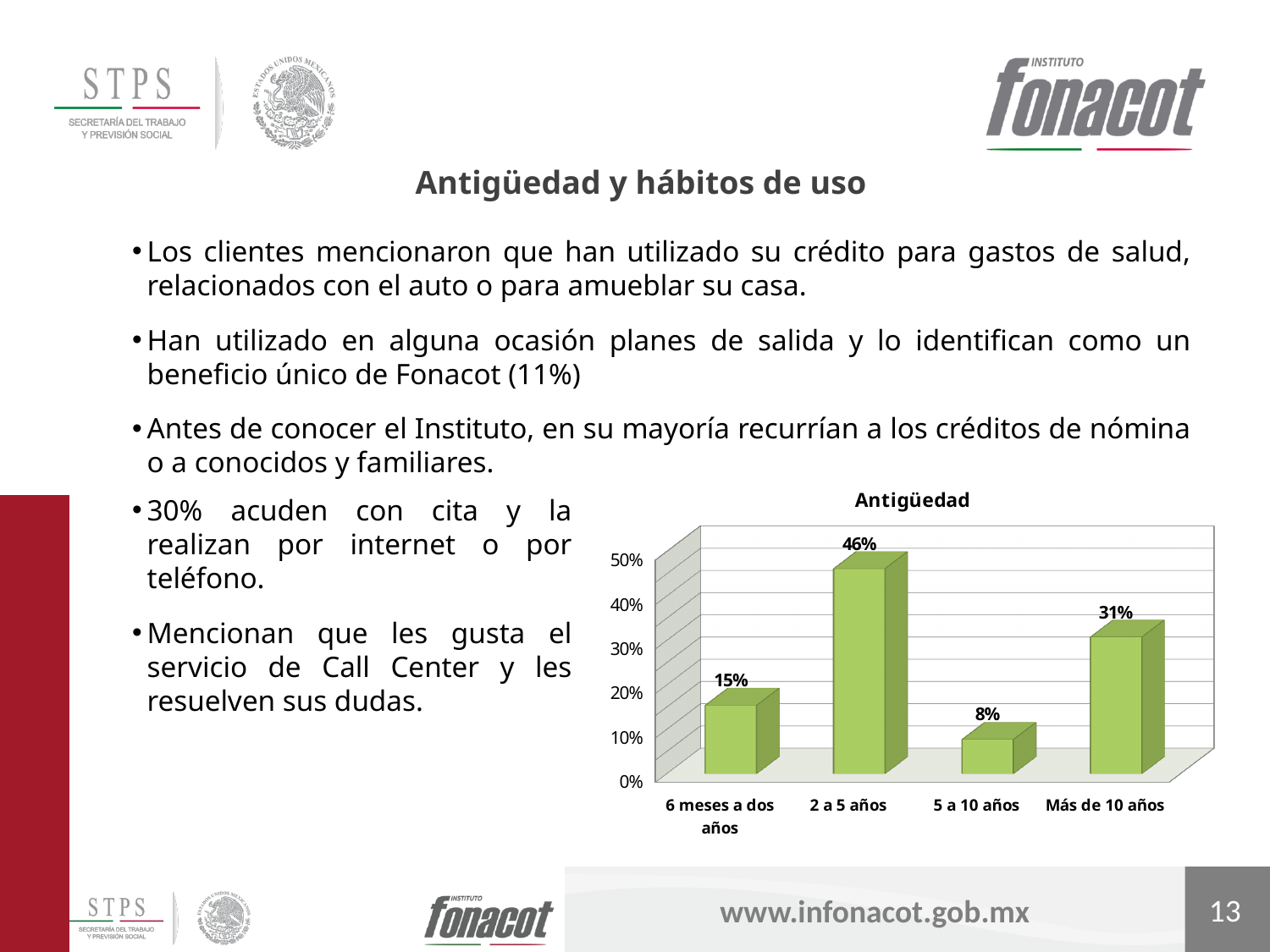
Which category has the lowest value in the Antigüedad chart? 5 a 10 años How many categories are shown in the Antigüedad chart? 4 What is the difference between the values for '2 a 5 años' and 'Más de 10 años'? 15% What kind of chart is shown on the slide? Bar chart What is the value for '5 a 10 años' in the Antigüedad chart? 8% What is the value for 'Más de 10 años' in the Antigüedad chart? 31% What is the value for '6 meses a dos años' in the Antigüedad chart? 15% What is the title of the chart on the slide? Antigüedad Which category has the highest value in the Antigüedad chart? 2 a 5 años What is the value for '2 a 5 años' in the Antigüedad chart? 46% What is the difference between the values for '6 meses a dos años' and '5 a 10 años'? 7% Which is larger: the value for '6 meses a dos años' or the value for 'Más de 10 años'? Más de 10 años